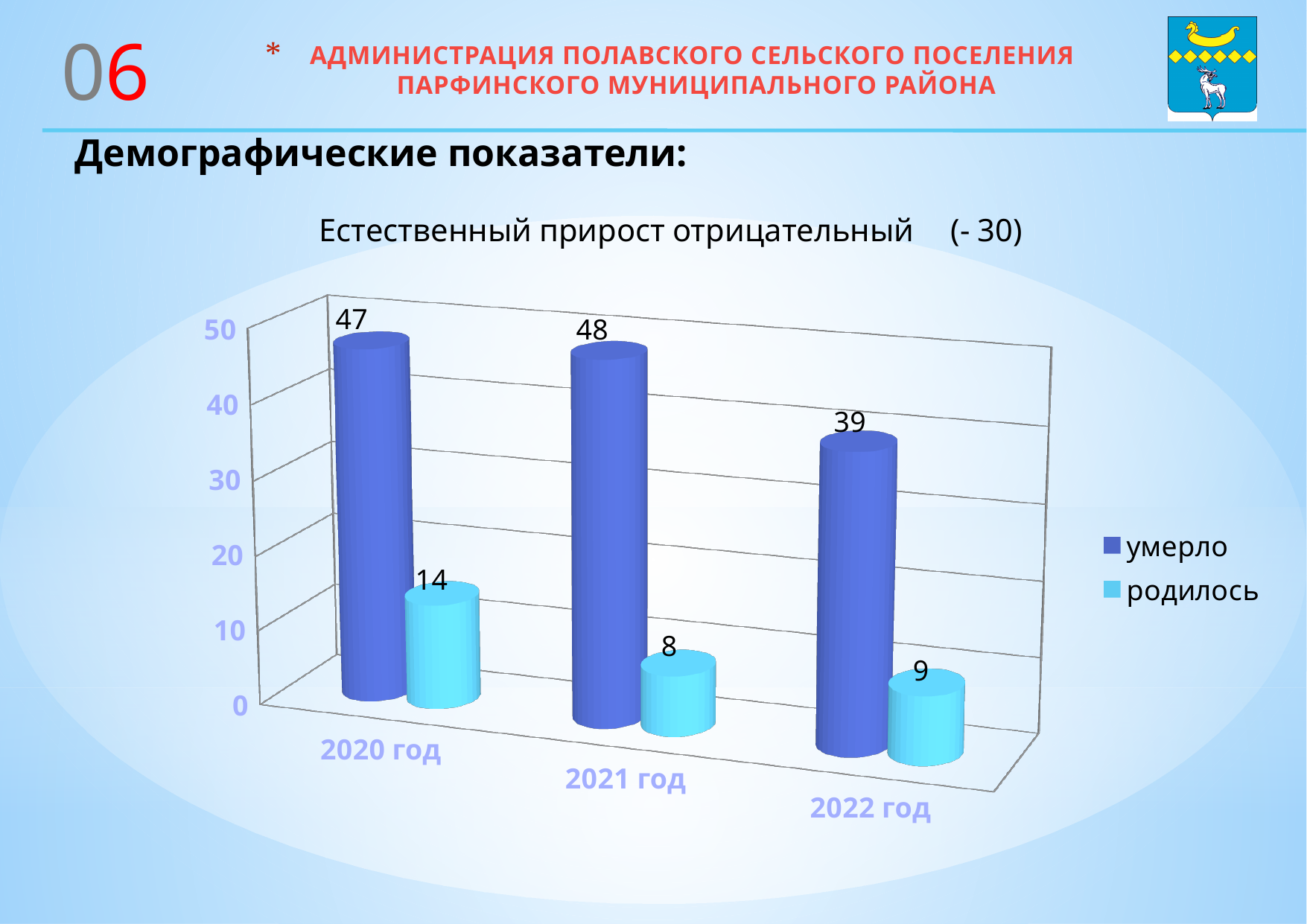
What is the value for умерло in 2022 год? 39 What is the value for родилось in 2021 год? 8 In which year is the родилось value lowest? 2021 год How many years are shown on the x axis? 3 Which is larger: родилось in 2020 год or родилось in 2022 год? родилось in 2020 год What is the value for родилось in 2020 год? 14 What is the difference between умерло and родилось in 2022 год? 30 What kind of chart is shown on the slide? bar chart In which year is the умерло value highest? 2021 год How many series does the legend list? 2 What is the title of the chart? Естественный прирост отрицательный (- 30) What is the value for умерло in 2020 год? 47